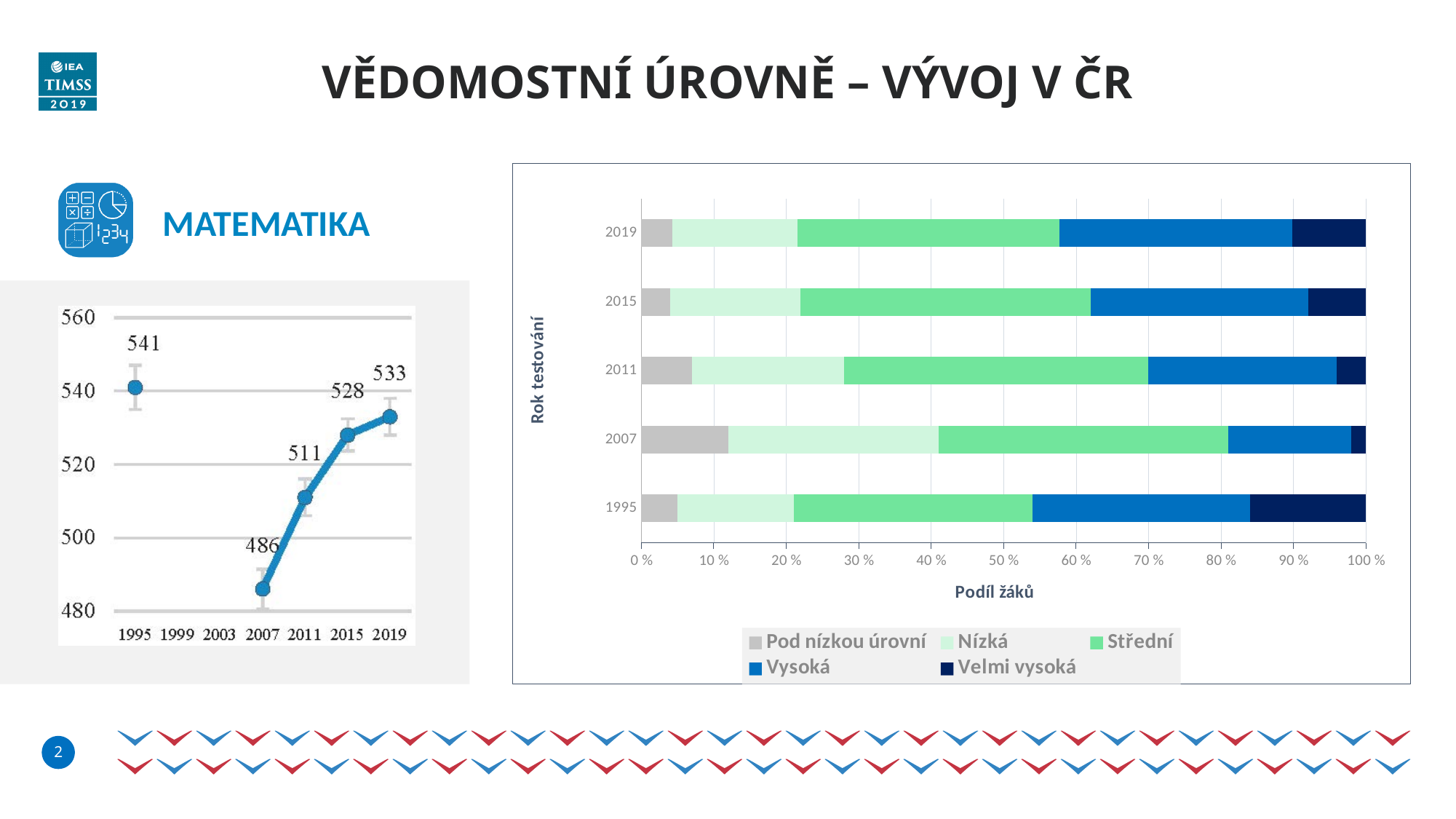
On the left line chart, what is the difference between the values for 2019 and 2007? 47 On the left line chart, which year has the highest value? 1995 On the right stacked bar chart, how many series does the legend list? 5 What kind of chart is the chart on the right? stacked bar chart On the left line chart, how many data points are plotted? 5 On the left line chart, do the values rise or fall from 2007 to 2019? rise On the left line chart, which year has the lowest value? 2007 On the left line chart, what is the value for 1995? 541 On the left line chart, what is the value for 2007? 486 On the left line chart, what is the value for 2019? 533 On the left line chart, which is larger, the value for 2011 or the value for 2015? 2015 On the right chart, is the share of 'Pod nízkou úrovní' for 2007 greater or less than 10 %? greater